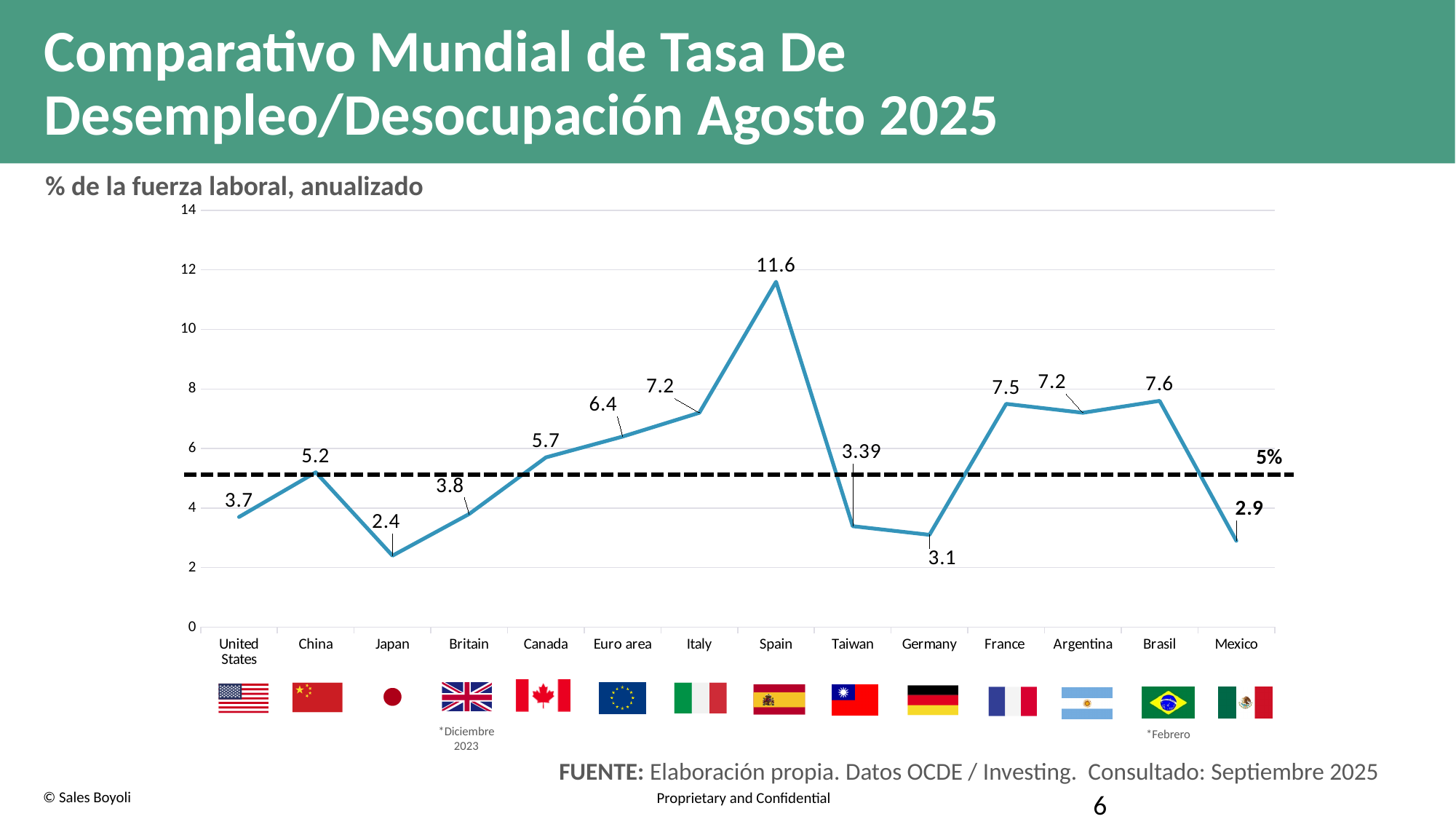
Which has a higher unemployment rate, Canada or Germany? Canada Is the value for Italy greater or less than 6? greater What value does the dashed horizontal reference line mark? 5% How many countries or regions are plotted on the chart? 14 Which country has the highest unemployment rate on the chart? Spain What is the difference between the values for Brasil and France? 0.1 What is the value plotted for Taiwan? 3.39 What is the unemployment rate shown for Spain? 11.6 What is the value shown for Mexico? 2.9 What is the difference between the values for Spain and Japan? 9.2 What kind of chart is shown on the slide? Line chart Which country has the lowest unemployment rate on the chart? Japan